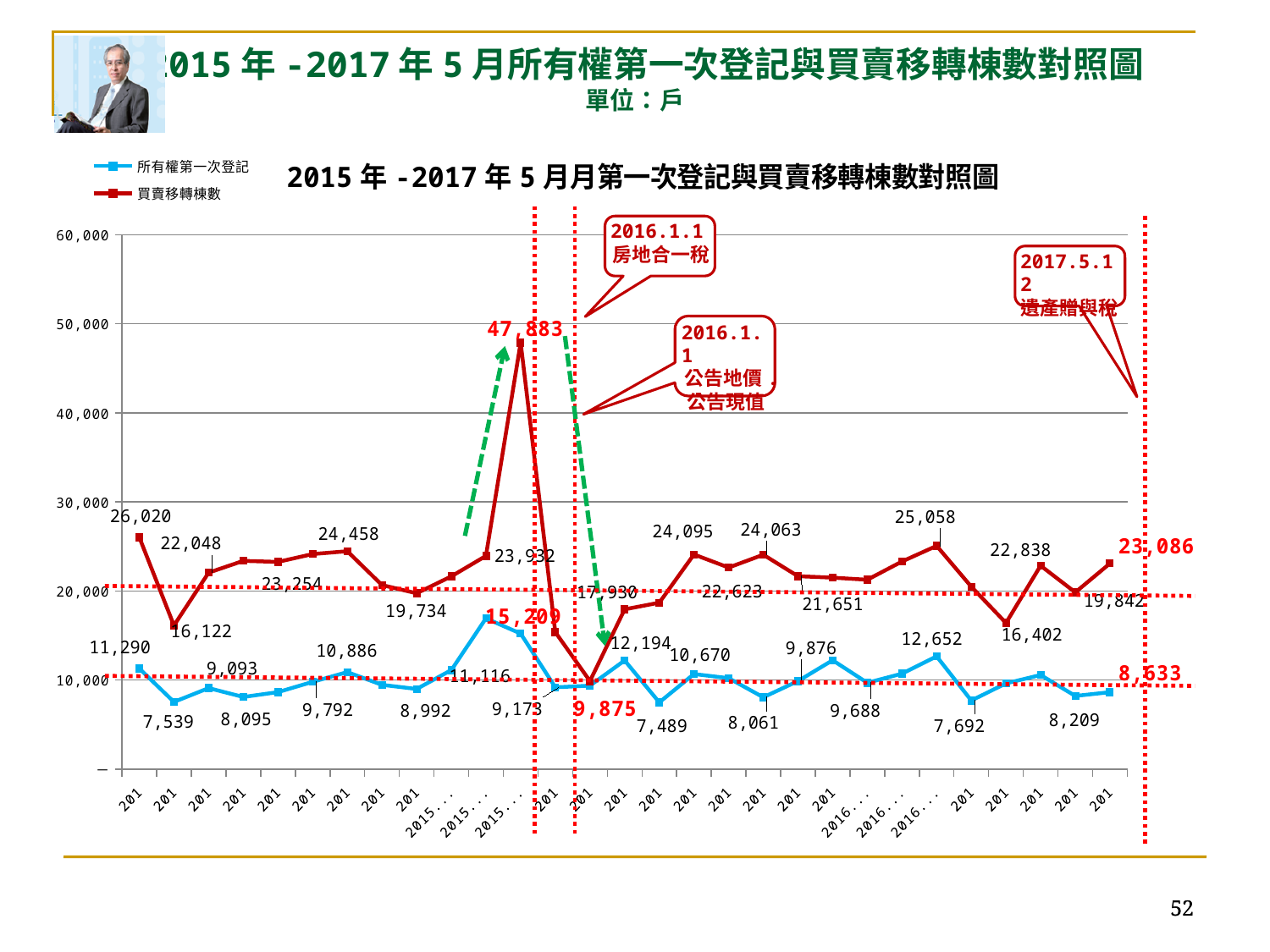
What is the difference between the peak value of 買賣移轉棟數 (47,883) and its lowest value (9,875)? 38,008 What is the lowest value reached by the 買賣移轉棟數 series? 9,875 What is the highest value reached by the 買賣移轉棟數 series? 47,883 How many series does the legend list? 2 What is the lowest value reached by the 所有權第一次登記 series? 7,489 What is the first plotted value of the 所有權第一次登記 series at the left end of the chart? 11,290 What are the two series named in the legend? 所有權第一次登記 and 買賣移轉棟數 Which series has the higher values across the chart, 所有權第一次登記 or 買賣移轉棟數? 買賣移轉棟數 Is the peak value of the 買賣移轉棟數 series greater or less than 40,000? greater What is the last plotted value of the 買賣移轉棟數 series at the right end of the chart? 23,086 What kind of chart is shown on the slide? line chart